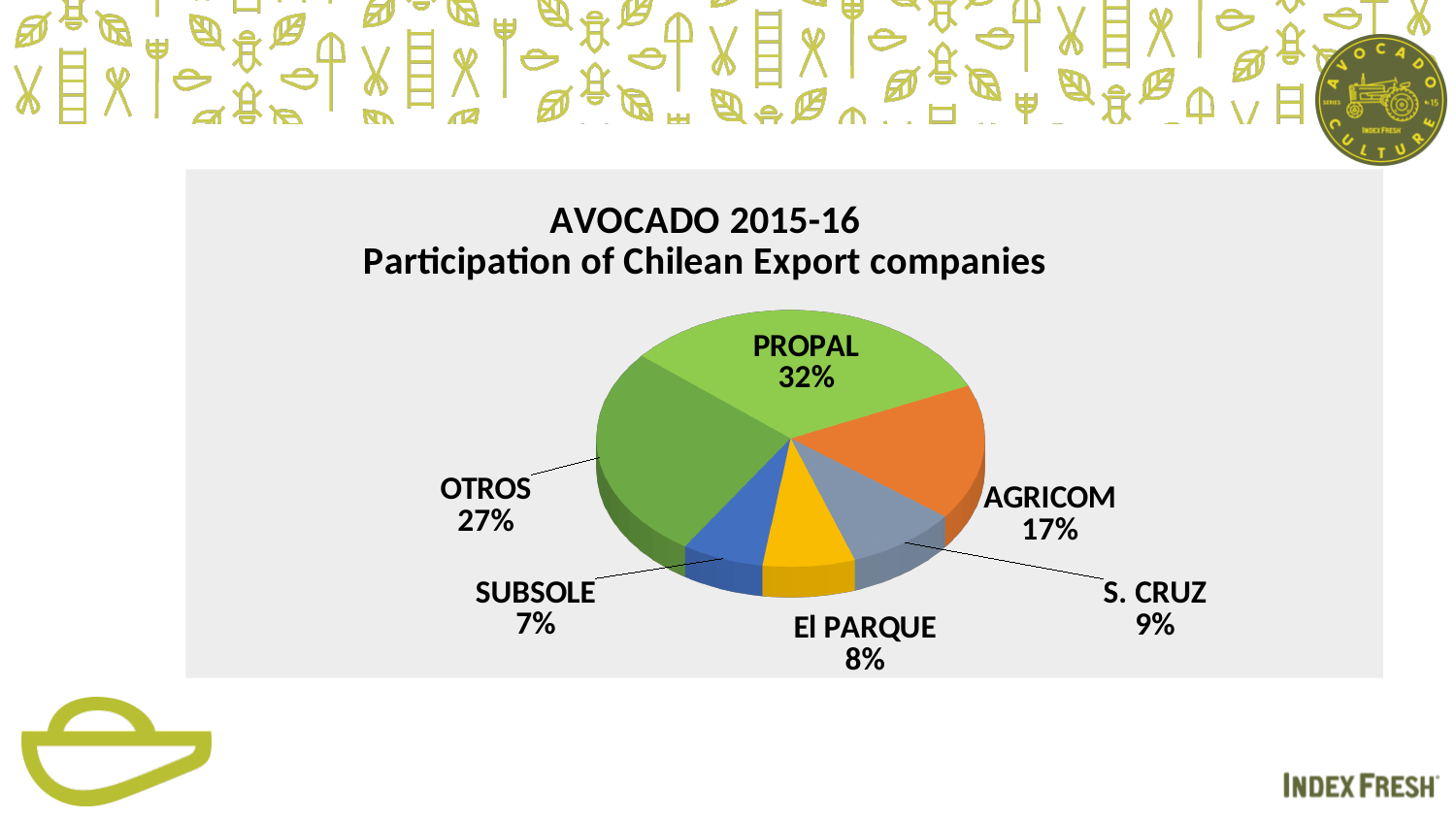
What share does PROPAL have in the pie chart? 32% What share does AGRICOM have in the pie chart? 17% How many slices does the pie chart have? 6 What share does SUBSOLE have in the pie chart? 7% Which company has the largest share in the pie chart? PROPAL What share does El PARQUE have in the pie chart? 8% What type of chart is shown on the slide? Pie chart Which has a larger share, AGRICOM or S. CRUZ? AGRICOM What share does S. CRUZ have in the pie chart? 9% Which company has the smallest share in the pie chart? SUBSOLE What is the difference between the shares of PROPAL and OTROS? 5% What is the title of the chart? AVOCADO 2015-16 Participation of Chilean Export companies